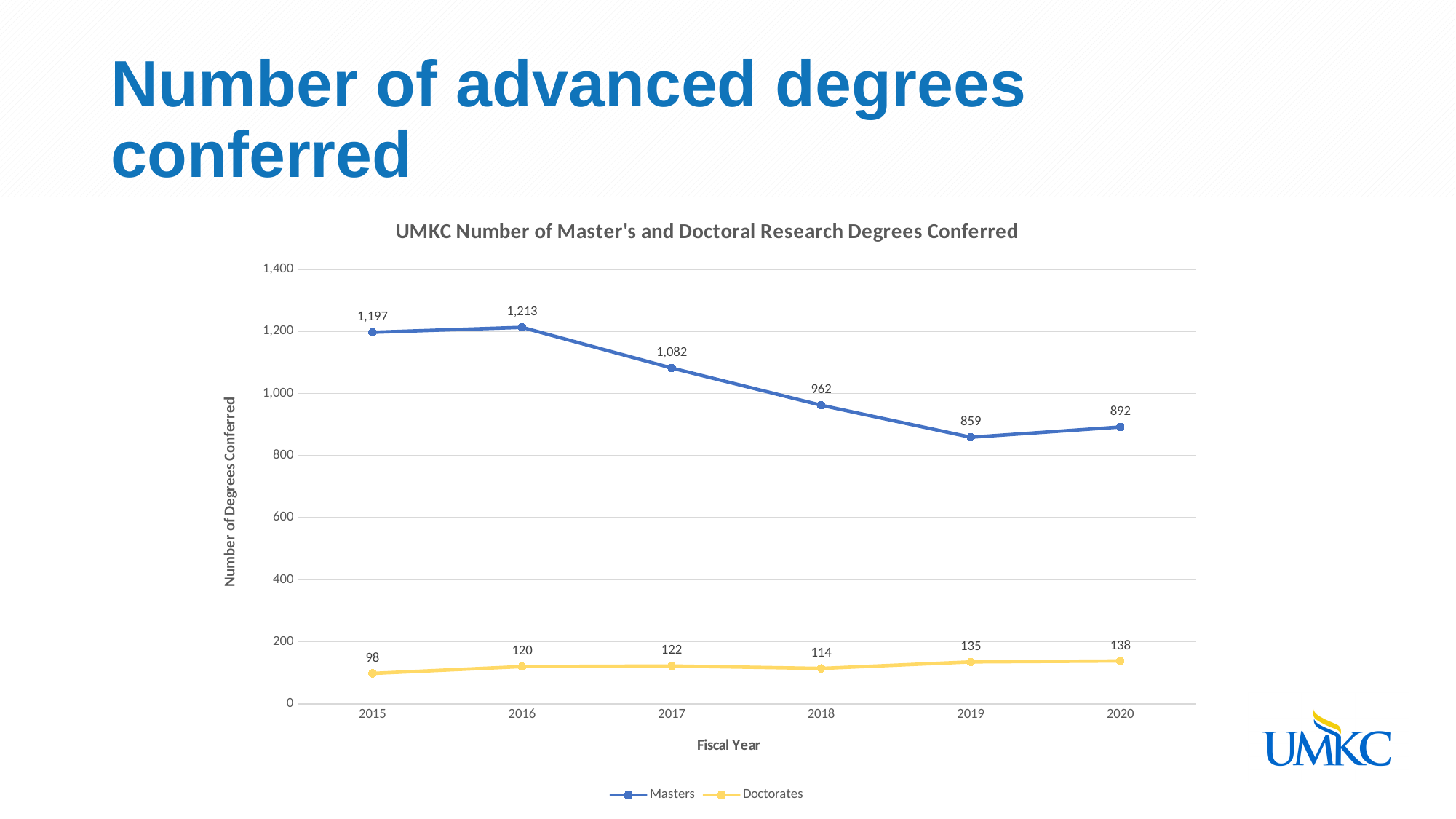
In which fiscal year was the number of Masters degrees conferred highest? 2016 Does the Masters series generally rise or fall from 2016 to 2019? fall Which is larger, the number of Doctorates conferred in 2018 or in 2020? 2020 How many fiscal years are plotted on the x axis? 6 How many series does the legend list? 2 How many Masters degrees were conferred in 2017? 1,082 What type of chart is shown on the slide? line chart In which fiscal year was the number of Doctorates conferred lowest? 2015 What is the difference between the Masters degrees conferred in 2016 and in 2019? 354 How many Doctorates were conferred in 2019? 135 Is the value for Masters in 2018 greater or less than 1,000? less What is the title of the chart? UMKC Number of Master's and Doctoral Research Degrees Conferred